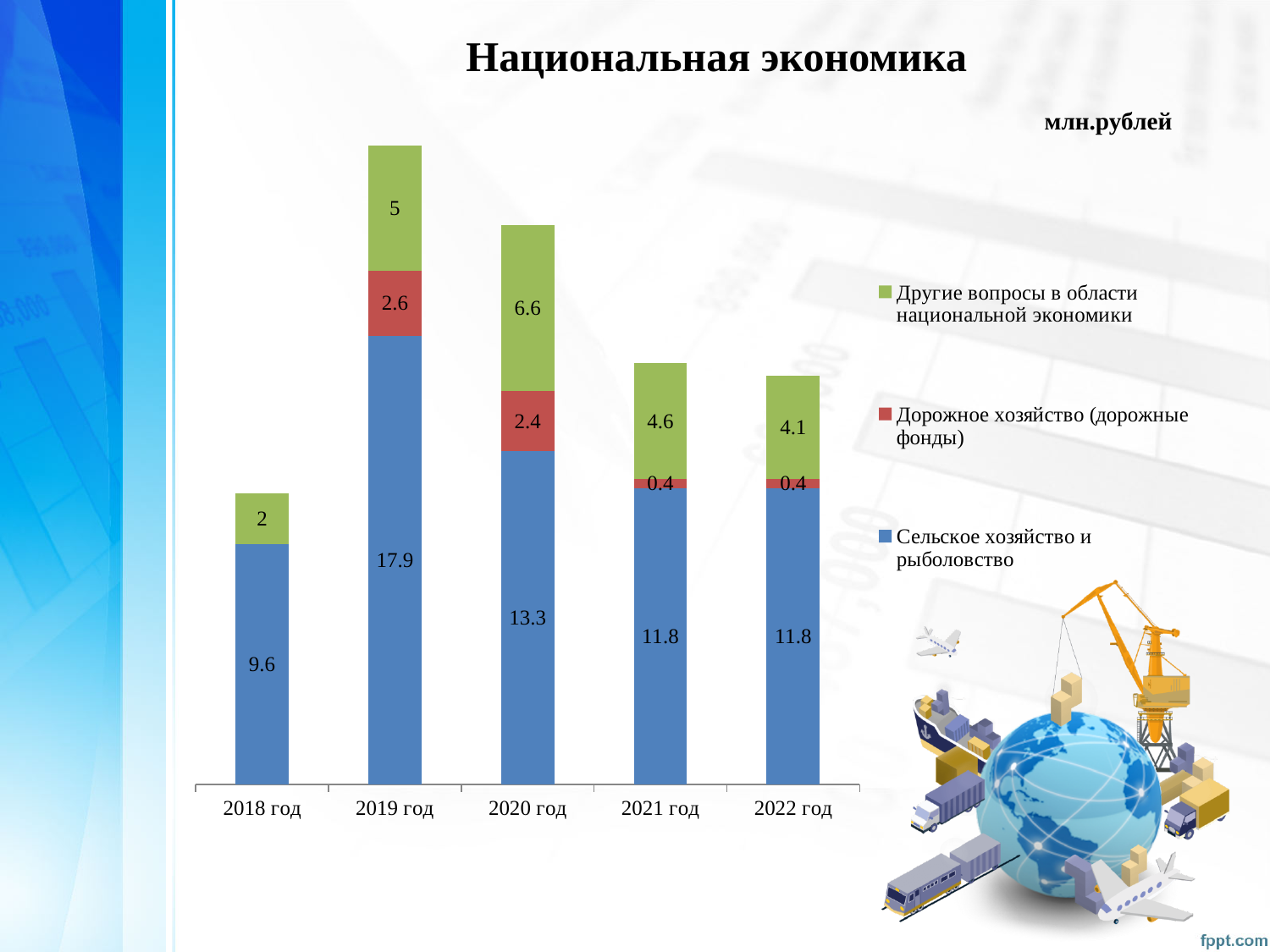
What is the total of the stacked bar for 2019 год? 25.5 What is the value for Другие вопросы в области национальной экономики in 2022 год? 4.1 In which year is the value for Другие вопросы в области национальной экономики the lowest? 2018 год What unit is stated for the values on the chart? млн.рублей How many years are shown on the x axis? 5 What kind of chart is shown on the slide? Stacked bar chart What is the value for Сельское хозяйство и рыболовство in 2019 год? 17.9 In which year is the value for Сельское хозяйство и рыболовство the highest? 2019 год Which is larger: the Другие вопросы в области национальной экономики value for 2020 год or for 2021 год? 2020 год How many series does the legend list? 3 What is the difference between the Сельское хозяйство и рыболовство values for 2019 год and 2020 год? 4.6 What is the value for Дорожное хозяйство (дорожные фонды) in 2020 год? 2.4